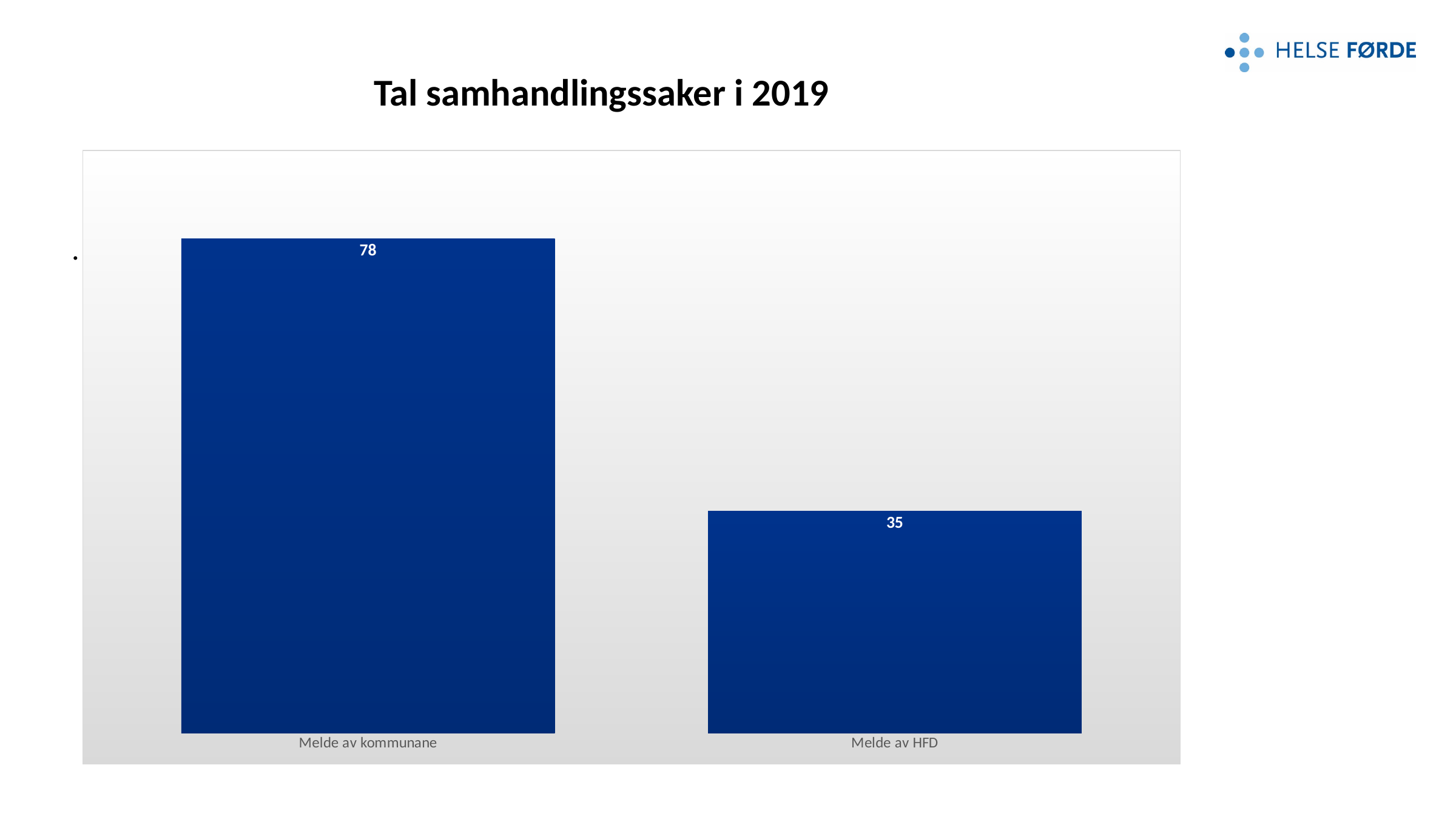
What is the total of the two values shown in the chart? 113 What is the value for Melde av kommunane? 78 What is the title of the slide? Tal samhandlingssaker i 2019 How many categories are shown in the chart? 2 Which category has the lowest value? Melde av HFD What is the difference between the values for Melde av kommunane and Melde av HFD? 43 What is the value for Melde av HFD? 35 Which category has the highest value? Melde av kommunane Which is larger, the value for Melde av kommunane or the value for Melde av HFD? Melde av kommunane What kind of chart is shown on the slide? Bar chart What colour are the bars in the chart? Dark blue